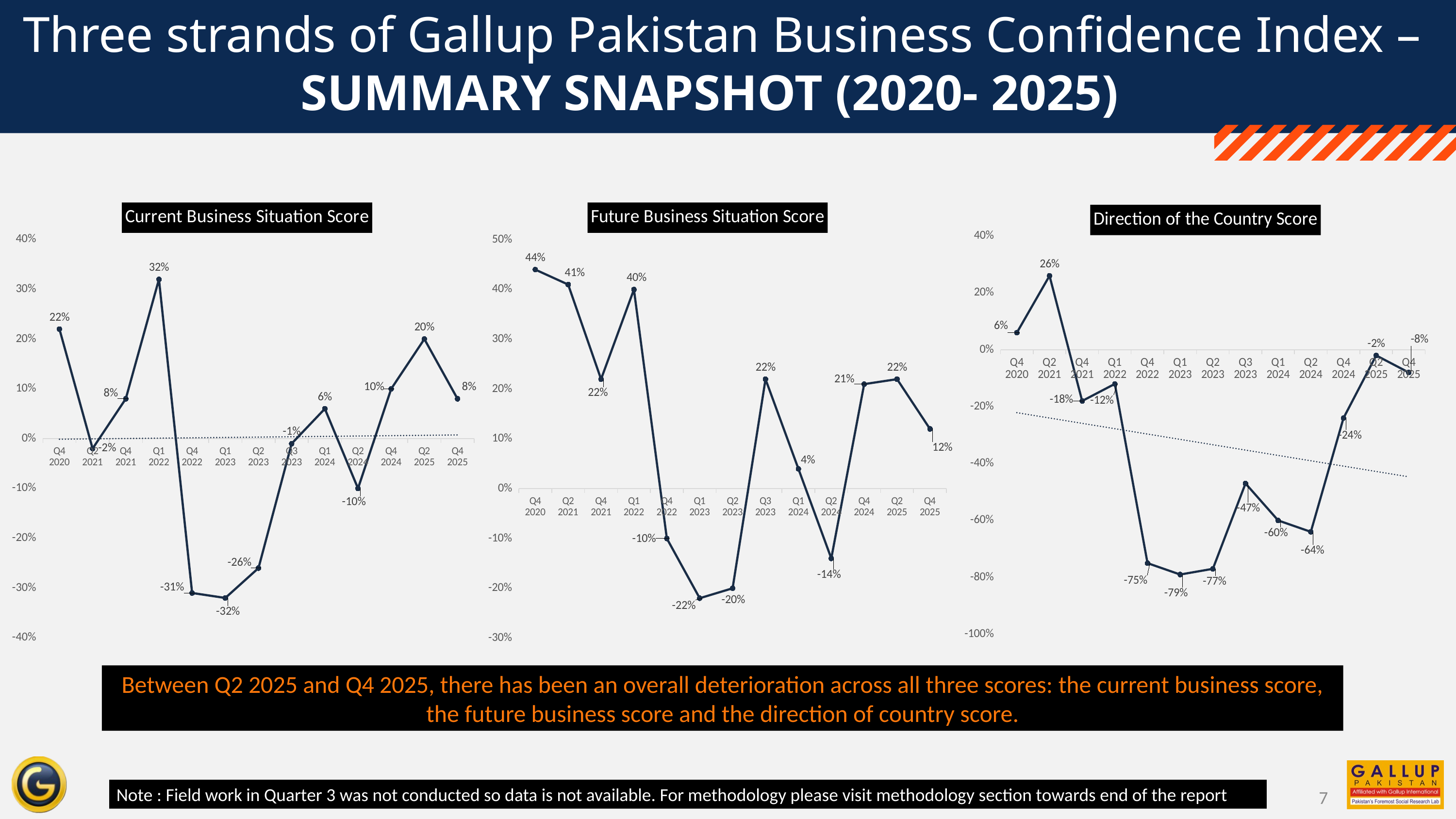
In the Direction of the Country Score chart, what is the difference between the Q4 2024 value and the Q2 2025 value? 22 percentage points In the Future Business Situation Score chart, what is the value for Q4 2020? 44% In the Current Business Situation Score chart, what is the difference between the Q2 2025 value and the Q4 2025 value? 12 percentage points How many data points are plotted in the Future Business Situation Score chart? 13 In the Future Business Situation Score chart, is the value for Q2 2025 or Q4 2025 larger? Q2 2025 In the Future Business Situation Score chart, which quarter has the lowest value? Q1 2023 In the Current Business Situation Score chart, what is the value for Q1 2022? 32% In the Current Business Situation Score chart, does the value rise or fall from Q2 2025 to Q4 2025? Fall What type of chart is the Direction of the Country Score chart? Line chart In the Direction of the Country Score chart, what is the value for Q1 2023? -79% In the Direction of the Country Score chart, which quarter has the highest value? Q2 2021 In the Current Business Situation Score chart, which quarter has the lowest value? Q1 2023